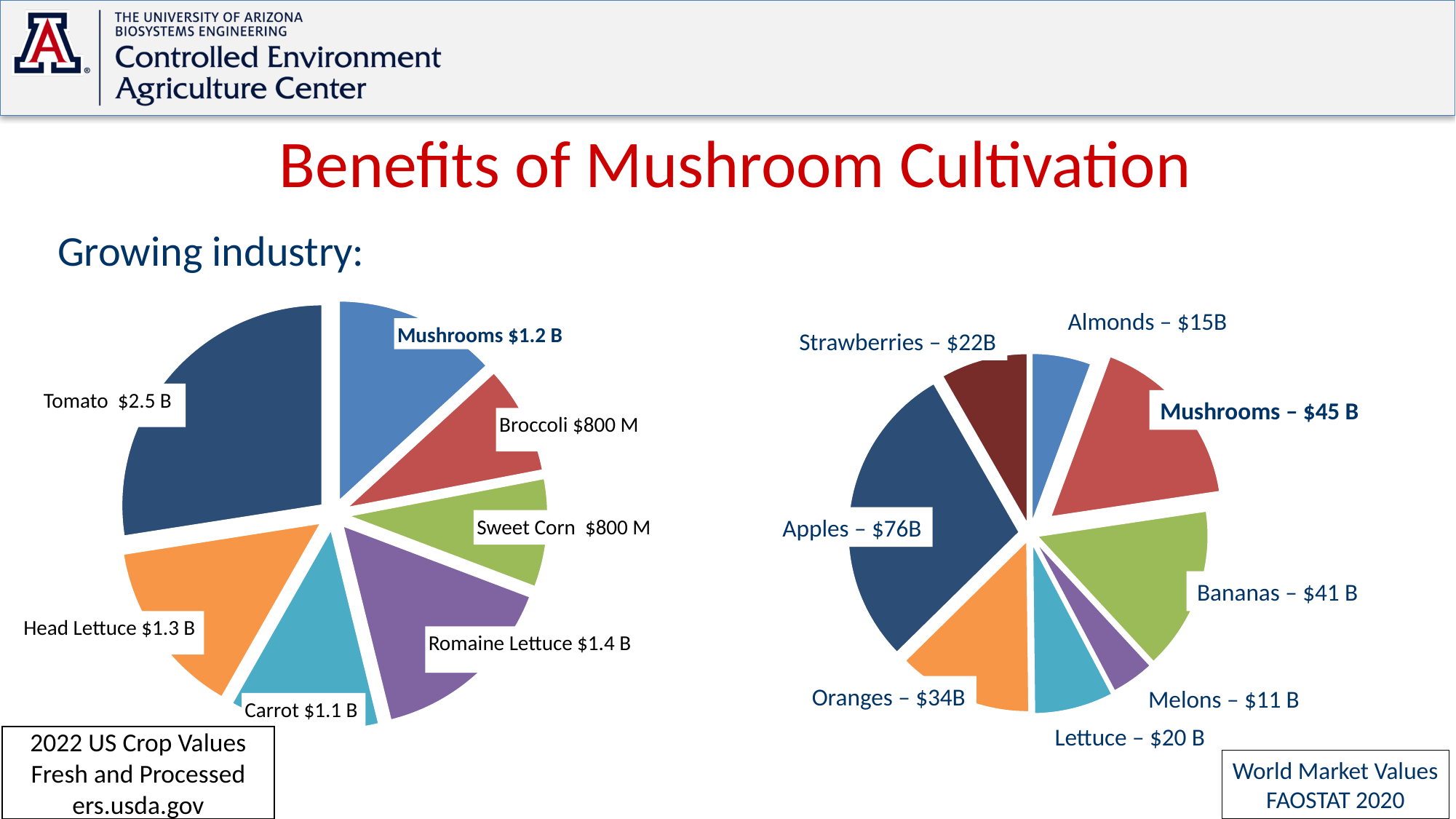
On the right pie chart (World Market Values), what is the difference between the Apples value and the Mushrooms value? $31 B On the right pie chart (World Market Values), which crop has the lowest value? Melons How many slices does the right pie chart (World Market Values) have? 8 On the left pie chart (2022 US Crop Values), what is the value for Mushrooms? $1.2 B On the left pie chart (2022 US Crop Values), what is the difference between the Tomato value and the Mushrooms value? $1.3 B On the right pie chart (World Market Values), what is the value for Mushrooms? $45 B What kind of chart is used for the World Market Values on the right? Pie chart On the left pie chart (2022 US Crop Values), which is larger, Romaine Lettuce or Head Lettuce? Romaine Lettuce How many slices does the left pie chart (2022 US Crop Values) have? 7 On the right pie chart (World Market Values), which crop has the highest value? Apples On the right pie chart (World Market Values), which is larger, Mushrooms or Bananas? Mushrooms On the left pie chart (2022 US Crop Values), which crop has the highest value? Tomato